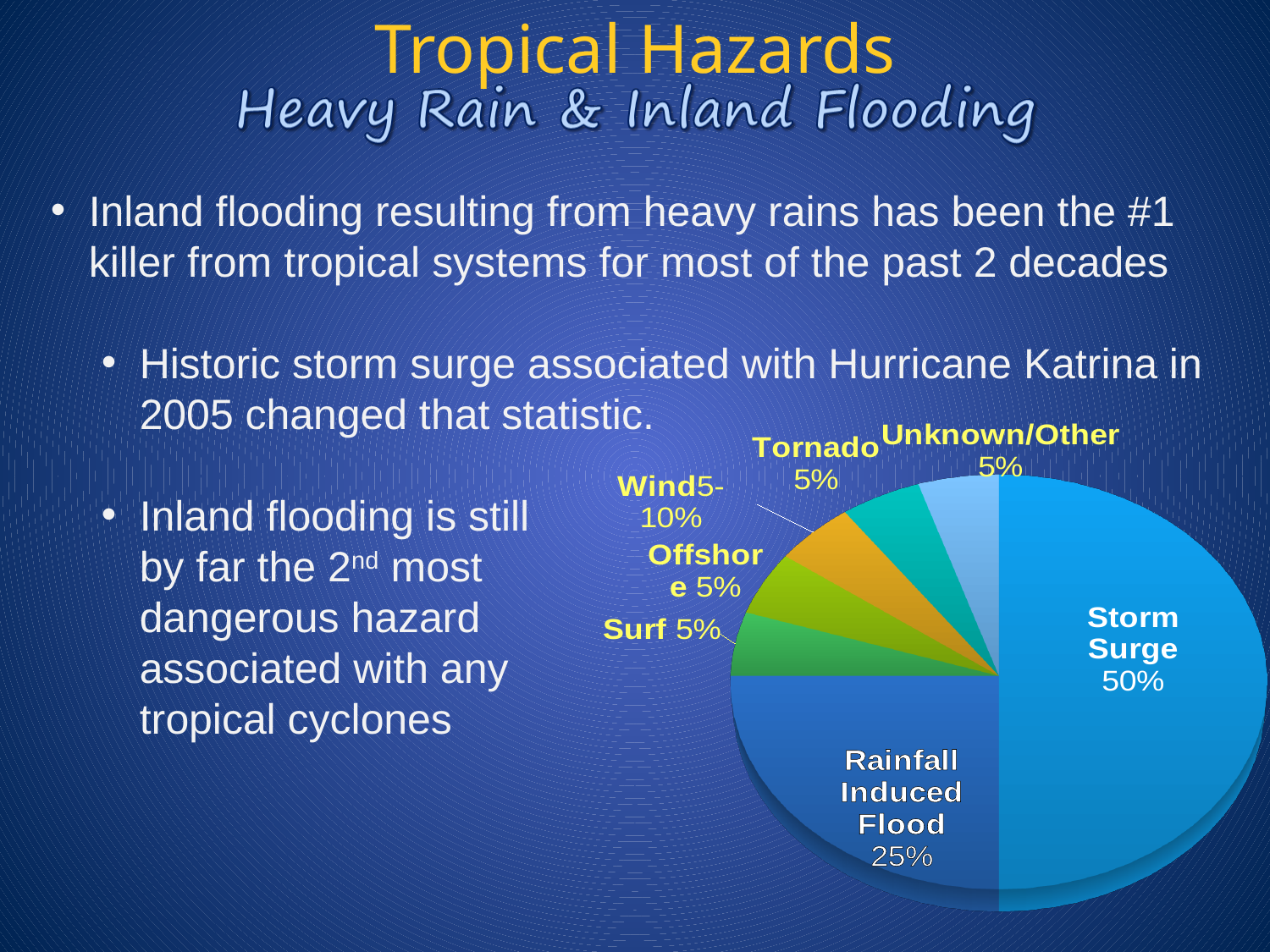
Which is larger, Storm Surge or Rainfall Induced Flood? Storm Surge What is the combined share of Storm Surge and Rainfall Induced Flood? 75% What value is shown for Surf? 5% What value is shown for Tornado? 5% What value is shown for Wind? 5-10% What kind of chart is shown on the slide? pie chart How many slices does the pie chart have? 7 Which category has the largest slice of the pie? Storm Surge What is the difference between the Storm Surge share and the Rainfall Induced Flood share? 25% What value is shown for Unknown/Other? 5% What share of the pie does Storm Surge account for? 50% What share of the pie does Rainfall Induced Flood account for? 25%